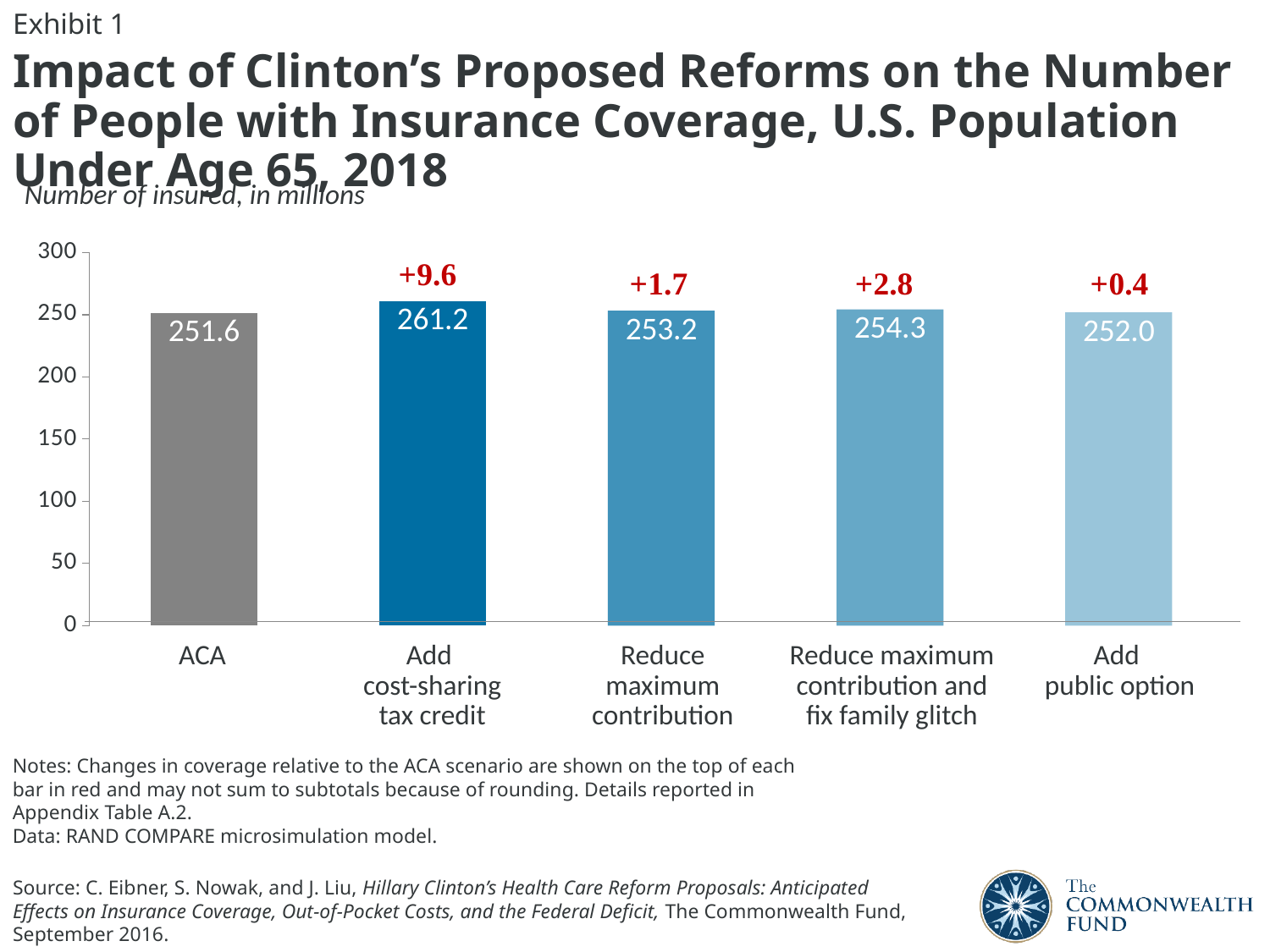
Which scenario has the highest number of insured? Add cost-sharing tax credit How many scenarios (bars) are shown in the chart? 5 Is the value for 'Reduce maximum contribution and fix family glitch' greater or less than 250? greater What is the number of insured (in millions) under the ACA scenario? 251.6 Which has a larger number of insured: 'Reduce maximum contribution' or 'Add public option'? Reduce maximum contribution What is the number of insured (in millions) for the 'Add cost-sharing tax credit' scenario? 261.2 Which scenario has the lowest number of insured? ACA What is the number of insured (in millions) for the 'Add public option' scenario? 252.0 What unit is the y axis measured in, according to the subtitle? Number of insured, in millions What change in coverage relative to the ACA is shown in red above the 'Reduce maximum contribution and fix family glitch' bar? +2.8 What is the difference in number of insured (in millions) between 'Add cost-sharing tax credit' and 'Reduce maximum contribution'? 8.0 What type of chart is shown on the slide? Bar chart